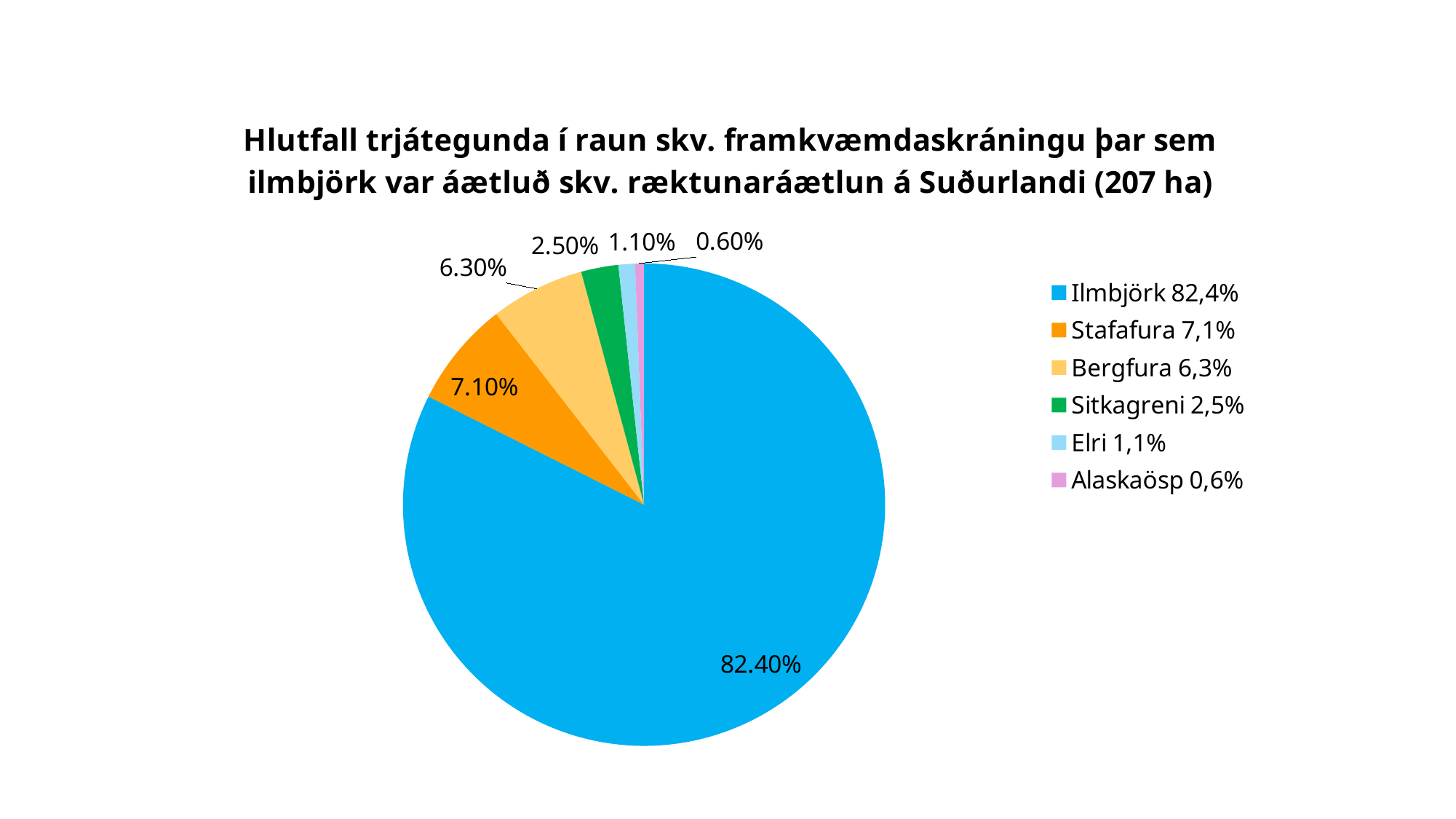
How many slices does the pie chart have? 6 Which slice is larger, Stafafura or Bergfura? Stafafura What is the data label shown for the Stafafura slice? 7.10% What is the data label shown for the Alaskaösp slice? 0.60% Which tree species has the smallest share of the pie? Alaskaösp What type of chart is shown on the slide? pie chart Which tree species has the largest share of the pie? Ilmbjörk What colour is the Sitkagreni slice? green What is the difference in percentage points between the Stafafura and Bergfura slices? 0.80% What is the data label shown for the Ilmbjörk slice? 82.40% What is the data label shown for the Sitkagreni slice? 2.50% What is the data label shown for the Bergfura slice? 6.30%